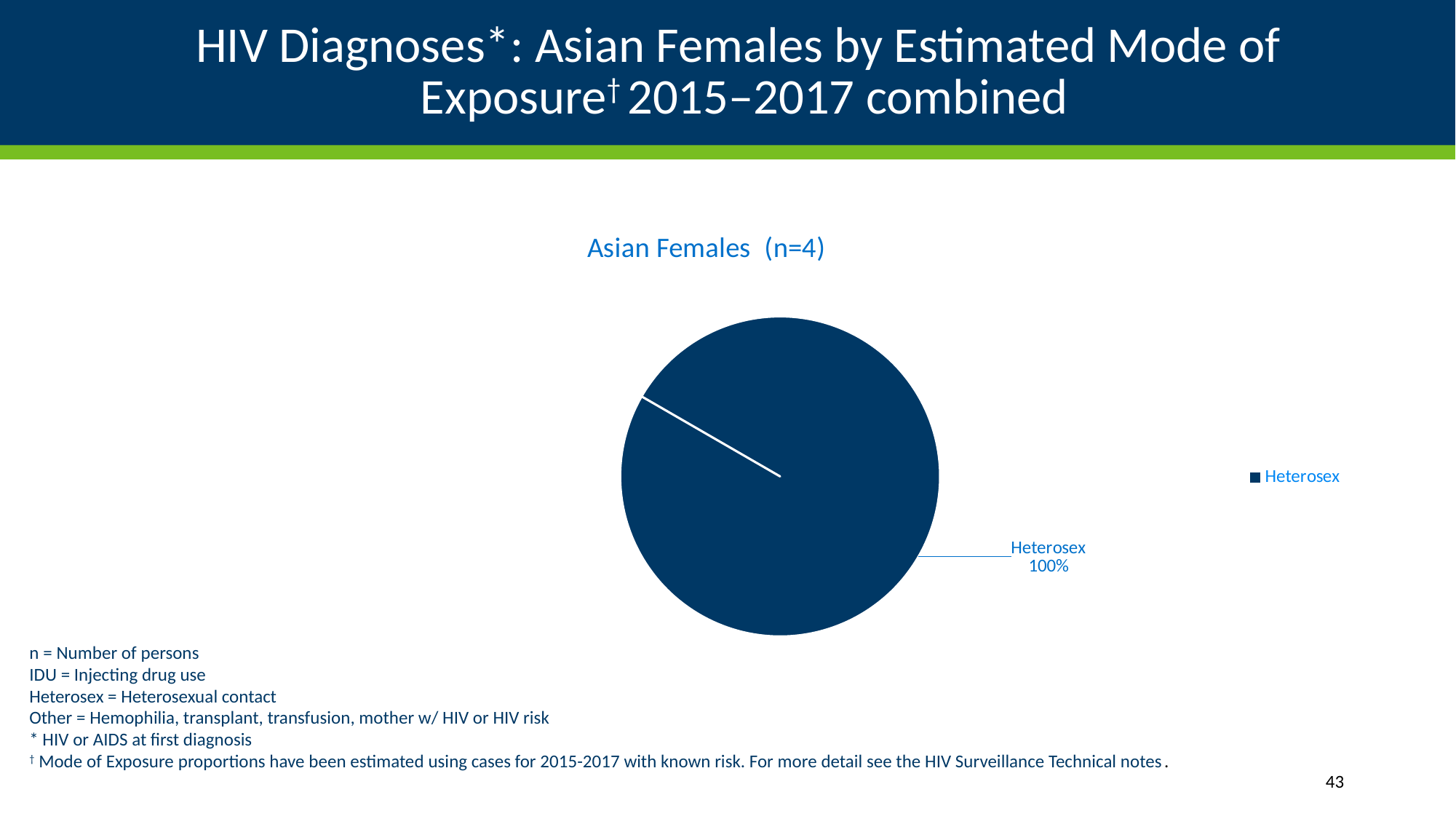
What is the only entry in the chart's legend? Heterosex Is the value for Heterosex greater or less than 50%? greater What is the title of the chart? Asian Females (n=4) What is the value shown for Heterosex in the pie chart? 100% How many slices does the pie chart have? 1 What kind of chart is shown on the slide? pie chart Which mode of exposure accounts for the largest share of the pie? Heterosex How many series does the legend list? 1 What share of the pie does the Heterosex slice represent? 100%